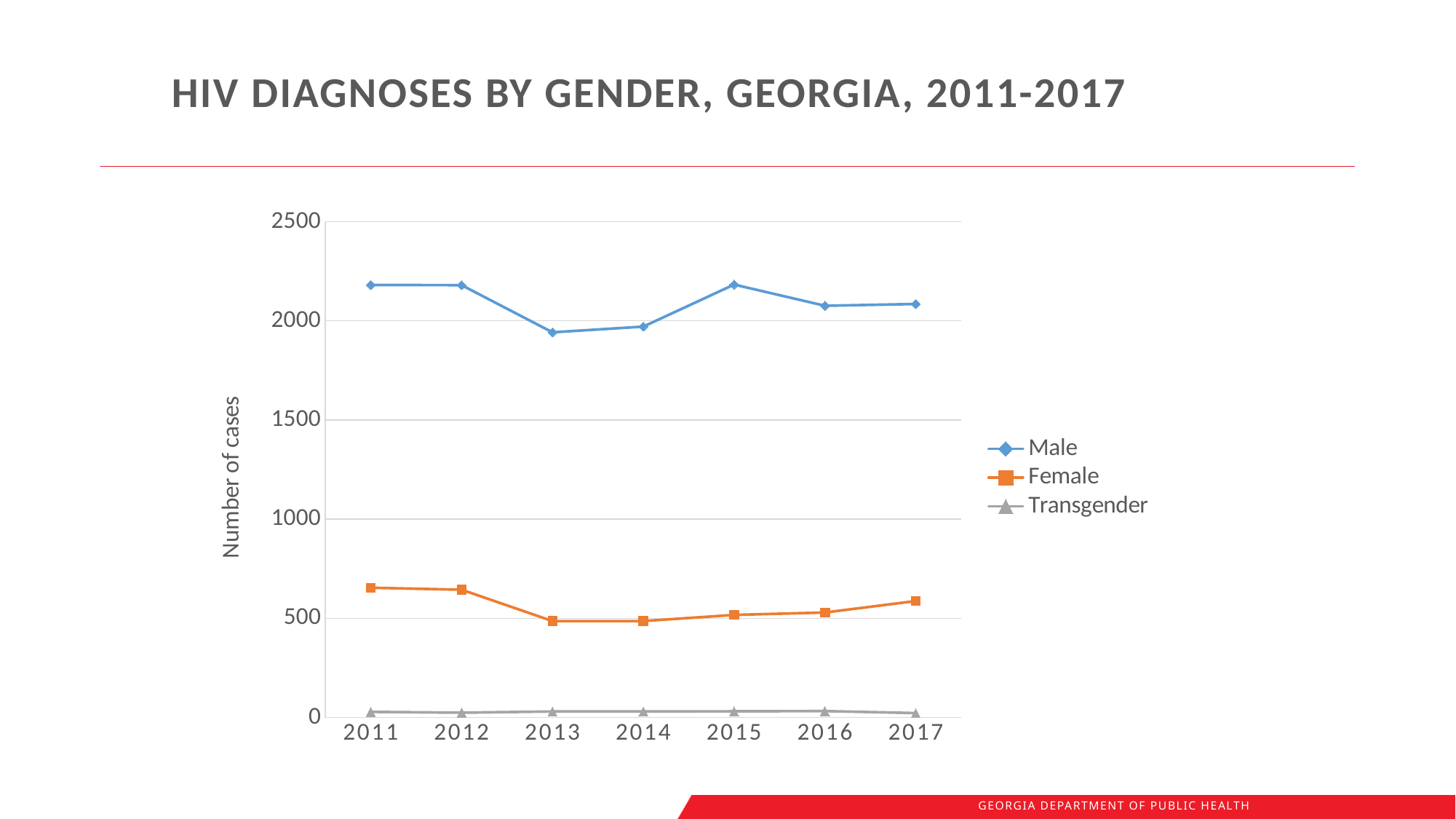
Is the value for Female in 2011 greater or less than 500? greater Is the value for Male in 2013 greater or less than 2000? less Is the value for Male in 2011 greater or less than 2000? greater Which is larger for the Female series: the value in 2014 or the value in 2017? 2017 What kind of chart is shown on the slide? line chart What is the label on the vertical axis? Number of cases Which series has the highest number of cases in every year? Male Which series has the lowest number of cases in every year? Transgender How many series does the legend list? 3 Does the Female series rise or fall from 2014 to 2017? rise How many years are plotted along the x axis? 7